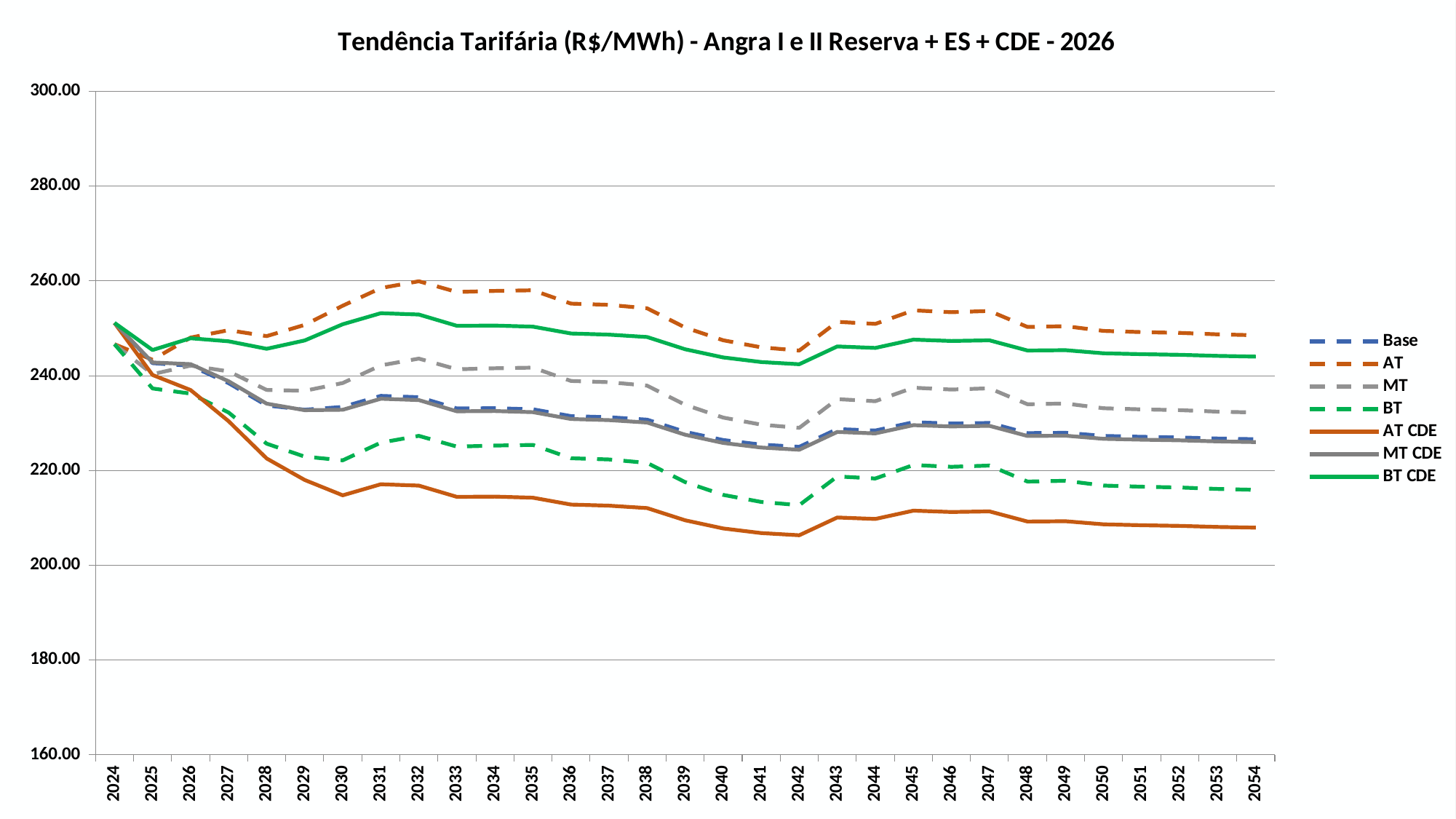
Which series has the lowest value in 2054? AT CDE What is the title of the chart? Tendência Tarifária (R$/MWh) - Angra I e II Reserva + ES + CDE - 2026 Which series has the highest value in 2032? AT Does the AT CDE series rise or fall from 2024 to 2030? fall Is the value for AT CDE in 2042 greater or less than 220? less Is the value for BT in 2042 greater or less than 220? less Which series has the lowest value in 2030? AT CDE Is the value for AT in 2032 greater or less than 240? greater How many years are plotted along the x axis? 31 What kind of chart is shown on the slide? line chart In 2054, which is higher: BT CDE or MT? BT CDE How many series does the legend list? 7